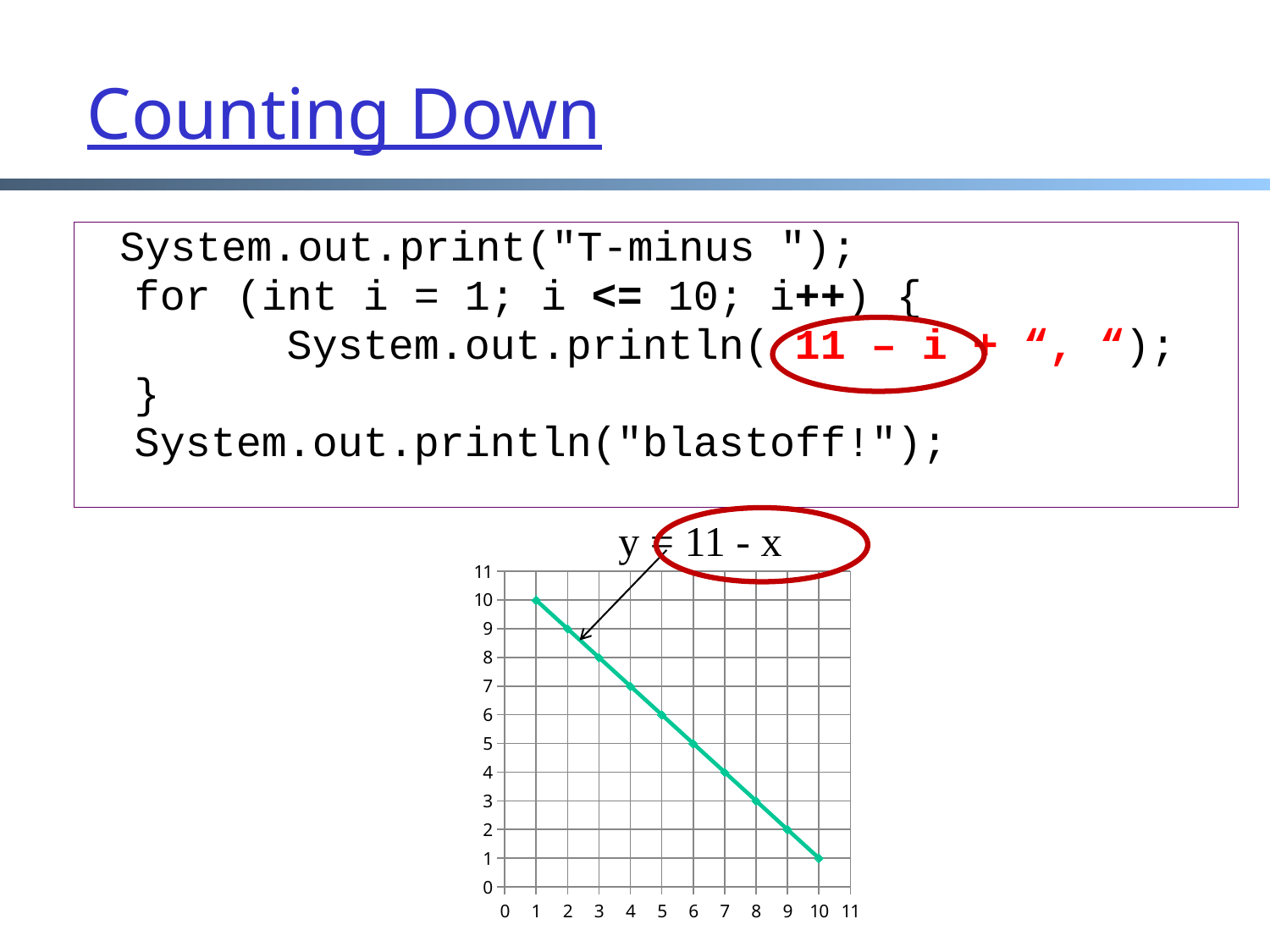
What is the y value at x = 5? 6 What is the y value at x = 1? 10 What equation is written above the chart? y = 11 - x Which is larger, the y value at x = 3 or the y value at x = 8? x = 3 Do the y values rise or fall as x increases? fall What is the highest tick value shown on the y axis? 11 What is the y value at x = 10? 1 At which x value is y highest? 1 What is the difference between the y value at x = 1 and the y value at x = 10? 9 At which x value is y lowest? 10 How many data points are plotted on the line? 10 What kind of chart is shown on the slide? line chart